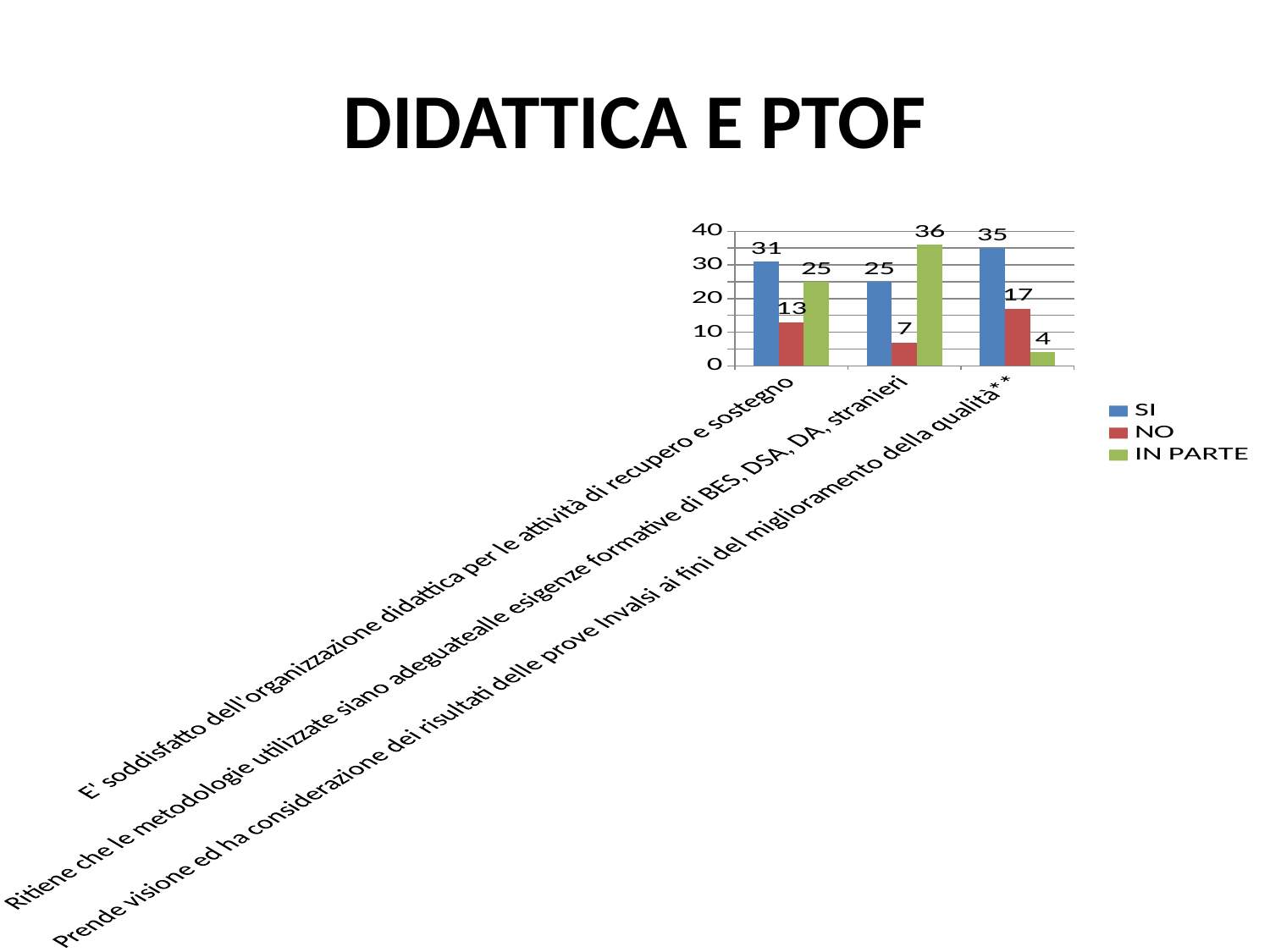
What is the difference between the SI and NO values for the category about recovery and support activities ("E' soddisfatto dell'organizzazione didattica...")? 18 Is the NO value for the category "Ritiene che le metodologie utilizzate siano adeguate..." greater or less than 10? less How many categories are shown on the x axis of the chart? 3 What is the NO value for the category about the Invalsi test results ("Prende visione ed ha considerazione dei risultati delle prove Invalsi...")? 17 What is the IN PARTE value for the category "Ritiene che le metodologie utilizzate siano adeguate alle esigenze formative di BES, DSA, DA, stranieri"? 36 How many series does the legend list? 3 What is the SI value for the category about the organisation of recovery and support activities ("E' soddisfatto dell'organizzazione didattica per le attività di recupero e sostegno")? 31 Which category has the highest SI value? Prende visione ed ha considerazione dei risultati delle prove Invalsi ai fini del miglioramento della qualità** What colour represents the NO series in the chart? red What kind of chart is shown on the slide? bar chart Which category has the lowest IN PARTE value? Prende visione ed ha considerazione dei risultati delle prove Invalsi ai fini del miglioramento della qualità** For the category "Ritiene che le metodologie utilizzate siano adeguate...", which is larger: the SI value or the IN PARTE value? IN PARTE